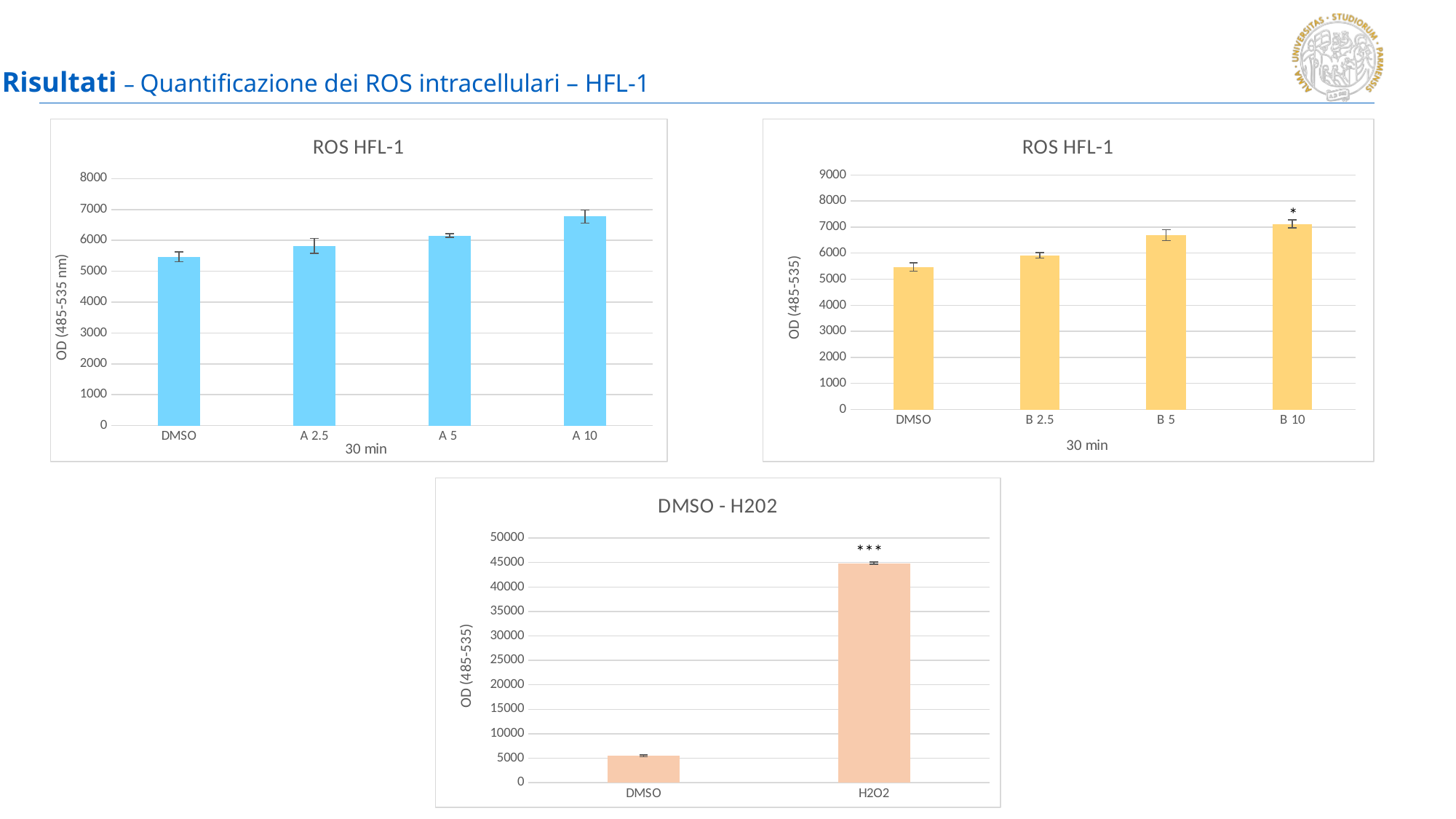
In the top-right chart (ROS HFL-1, yellow bars), which is larger, the value for B 5 or the value for B 2.5? B 5 In the top-left chart (ROS HFL-1, blue bars), which category has the highest value? A 10 In the bottom chart (DMSO - H202), is the value for H2O2 greater or less than 40000? greater In the bottom chart (DMSO - H202), which category has the highest value? H2O2 In the top-left chart (ROS HFL-1, blue bars), do the values rise or fall from DMSO to A 10? rise In the top-left chart (ROS HFL-1, blue bars), is the value for A 10 greater or less than 6000? greater In the top-right chart (ROS HFL-1, yellow bars), is the value for DMSO greater or less than 6000? less In the top-left chart (ROS HFL-1, blue bars), how many categories are shown on the x axis? 4 In the top-left chart (ROS HFL-1, blue bars), which category has the lowest value? DMSO In the top-right chart (ROS HFL-1, yellow bars), which category has the highest value? B 10 What kind of chart is the bottom chart (DMSO - H202)? bar chart